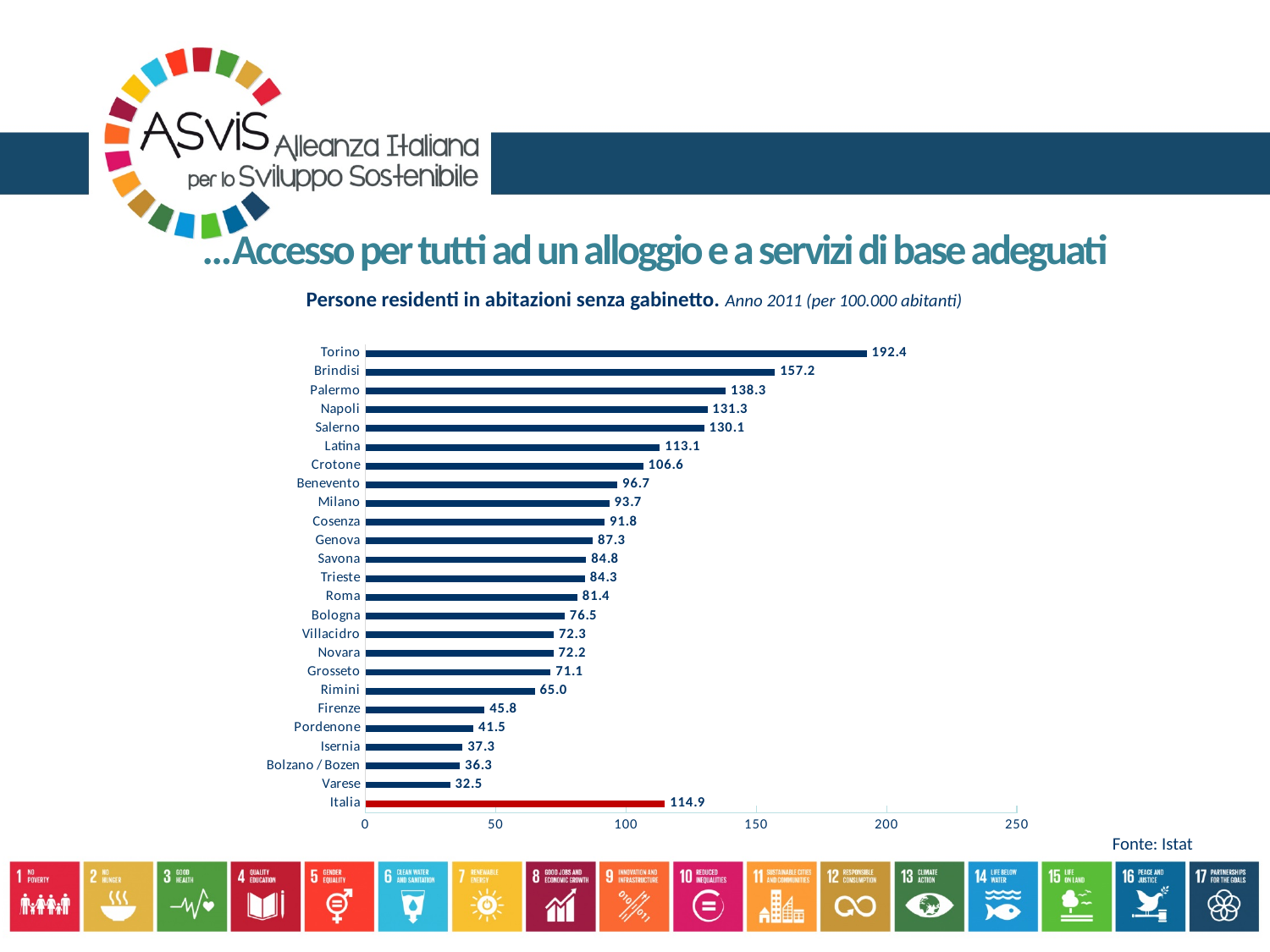
What is the source cited for the chart? Istat What is the difference between the values for Torino and Brindisi? 35.2 Is the value for Latina greater or less than 100? greater Which city has the lowest value? Varese What is the value for Torino? 192.4 What is the value for Bolzano / Bozen? 36.3 What is the value for Italia? 114.9 How many categories (bars) are shown in the chart? 25 What kind of chart is shown on the slide? Bar chart Which city has the highest value? Torino Which has a larger value, Milano or Roma? Milano What is the difference between the value for Italia and the value for Firenze? 69.1